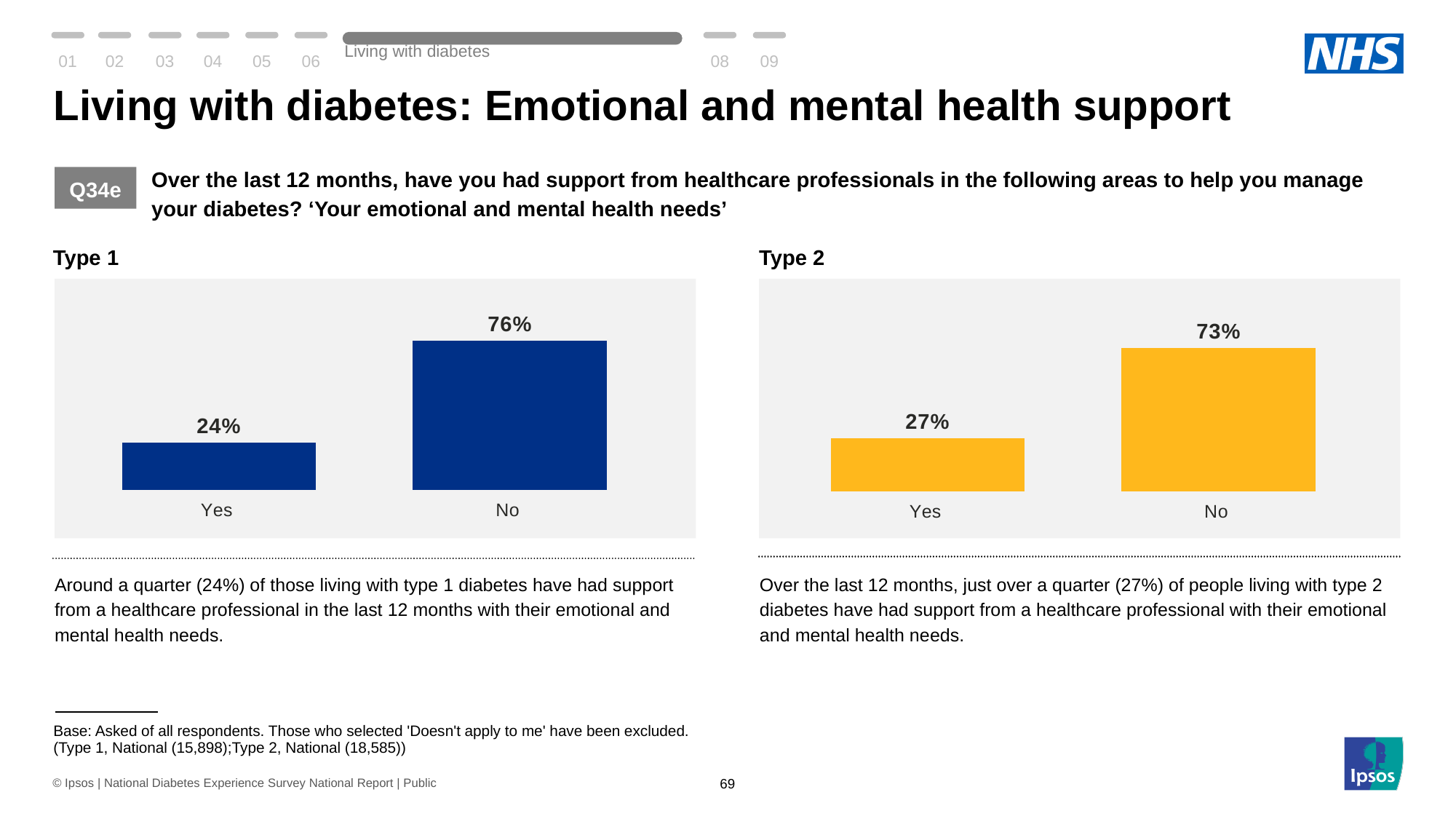
How many categories are shown in the Type 2 chart? 2 In the Type 2 chart, what percentage answered No? 73% In the Type 1 chart, what percentage answered No? 76% What kind of chart is the Type 1 chart? Bar chart Which is larger: the Yes value in the Type 1 chart or the Yes value in the Type 2 chart? Type 2 What colour are the bars in the Type 2 chart? Yellow In the Type 1 chart, which category has the highest value? No In the Type 1 chart, what is the difference between the No and Yes percentages? 52% In the Type 2 chart, what is the difference between the No and Yes percentages? 46% In the Type 2 chart, which category has the lowest value? Yes In the Type 2 chart, what percentage answered Yes? 27% In the Type 1 chart, what percentage answered Yes? 24%